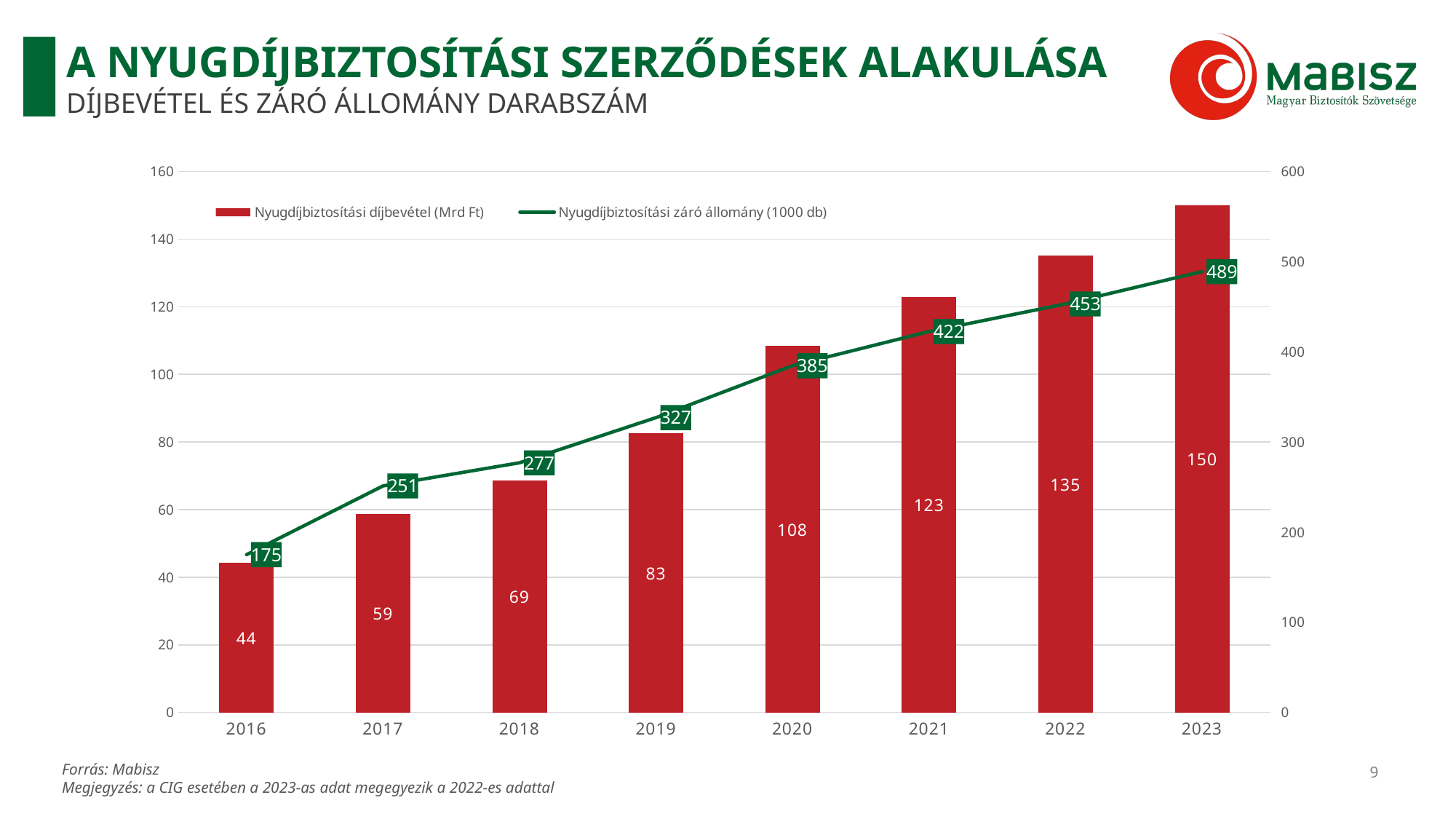
What is the value of Nyugdíjbiztosítási díjbevétel (Mrd Ft) for 2020? 108 Which year has the lowest Nyugdíjbiztosítási záró állomány (1000 db)? 2016 Which year has a larger Nyugdíjbiztosítási díjbevétel (Mrd Ft), 2018 or 2019? 2019 What is the difference in Nyugdíjbiztosítási záró állomány (1000 db) between 2022 and 2021? 31 How many years are shown on the x axis? 8 What is the difference in Nyugdíjbiztosítási díjbevétel (Mrd Ft) between 2023 and 2016? 106 How many series does the legend list? 2 What colour are the bars for Nyugdíjbiztosítási díjbevétel (Mrd Ft)? Red Do the values of Nyugdíjbiztosítási záró állomány (1000 db) rise or fall from 2016 to 2023? Rise Which year has the highest Nyugdíjbiztosítási díjbevétel (Mrd Ft)? 2023 What kind of chart is used for the Nyugdíjbiztosítási díjbevétel (Mrd Ft) series? Bar chart What is the value of Nyugdíjbiztosítási záró állomány (1000 db) for 2019? 327